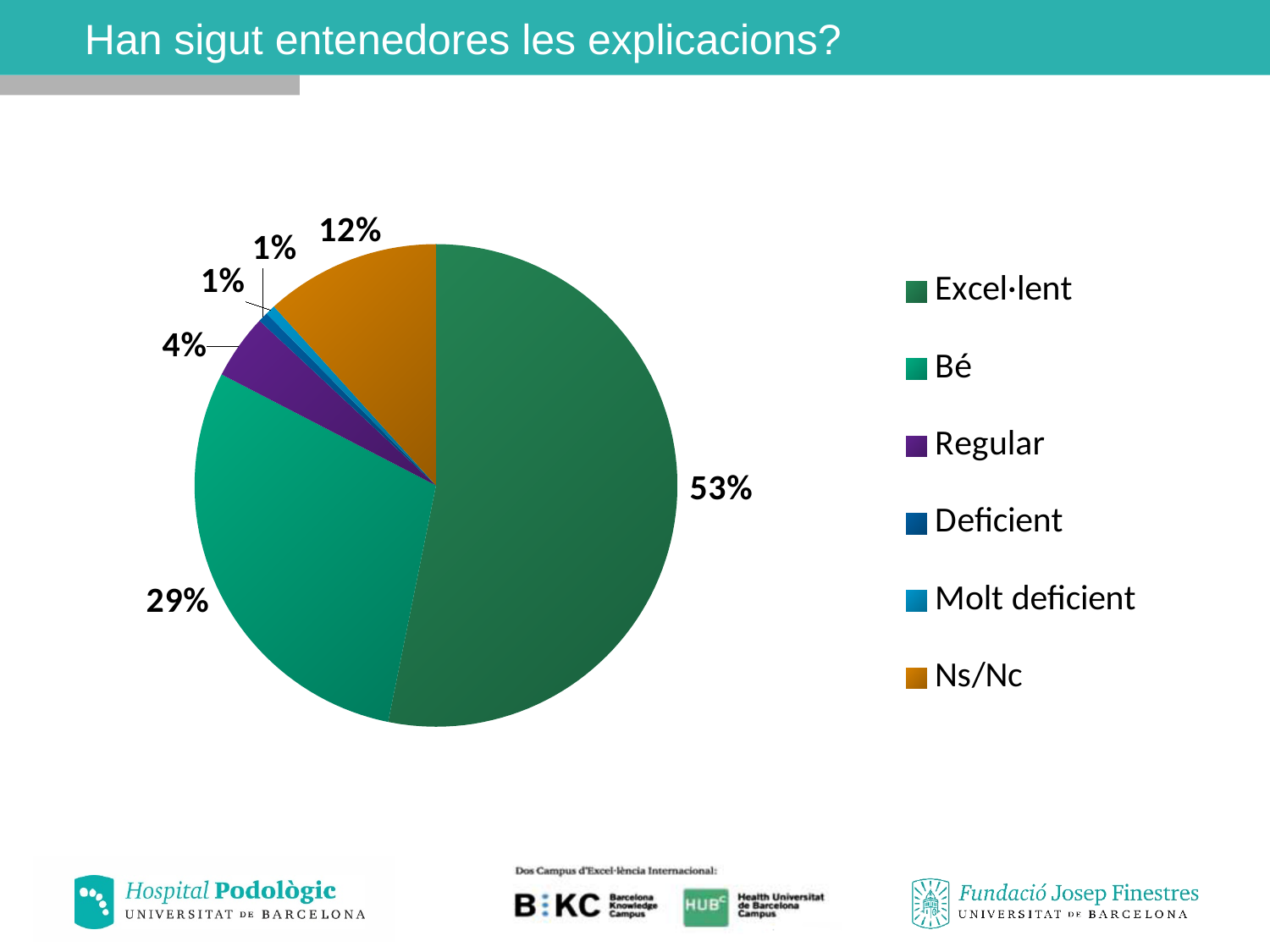
What share of the pie does Regular have? 4% Which category has the largest slice of the pie? Excel·lent Which legend entry is shown in orange? Ns/Nc What share of the pie does Ns/Nc have? 12% What kind of chart is shown on the slide? pie chart How many categories does the legend list? 6 Which is larger, the Ns/Nc slice or the Regular slice? Ns/Nc What is the difference between the Excel·lent share and the Bé share? 24% What is the title of the slide containing the chart? Han sigut entenedores les explicacions? What share of the pie does Bé have? 29% What is the combined share of Excel·lent and Bé? 82% What share of the pie does Excel·lent have? 53%